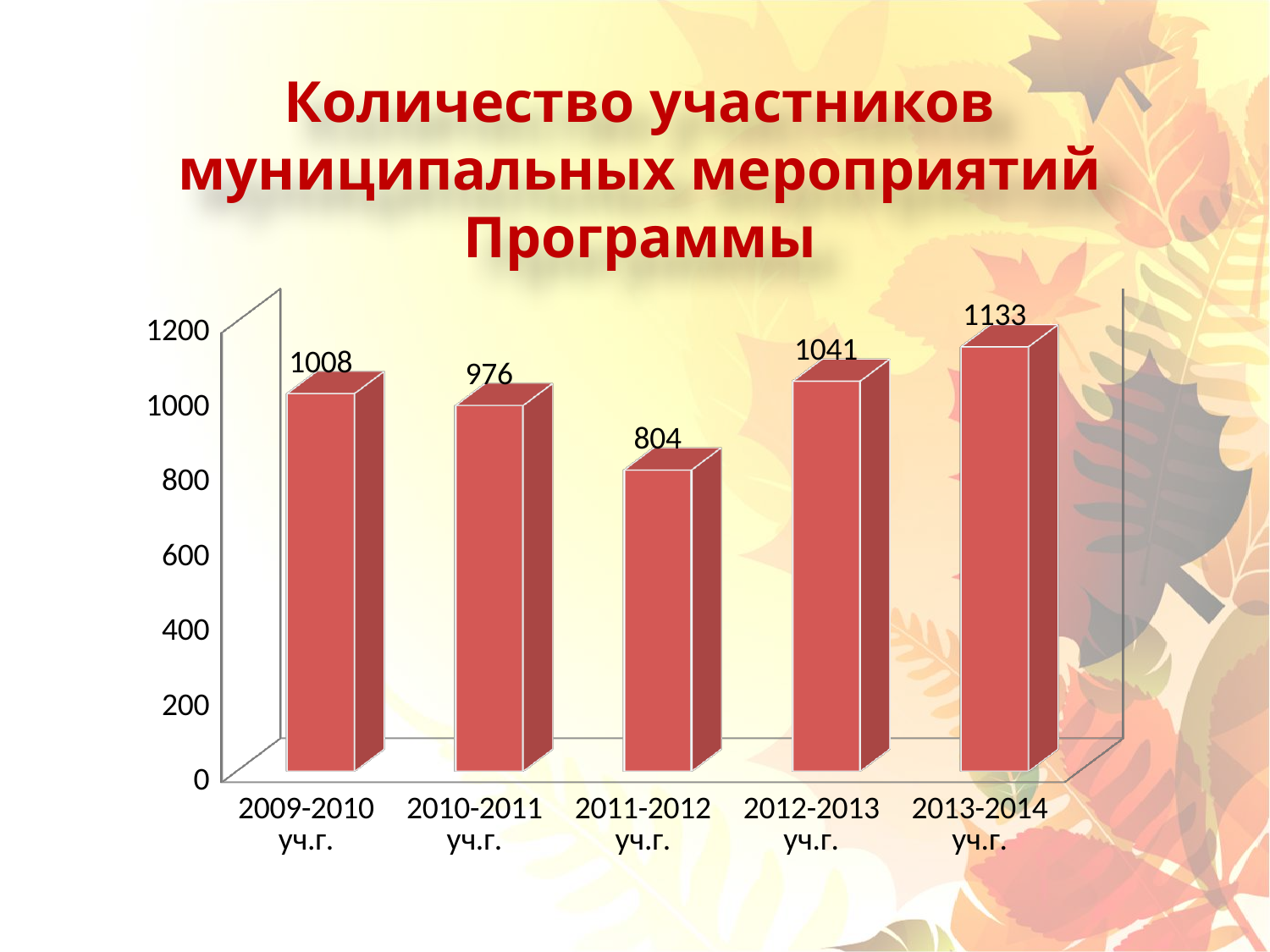
How many academic years are shown on the chart? 5 Is the value for 2011-2012 уч.г. greater or less than 1000? less What is the value for 2009-2010 уч.г.? 1008 What is the title of the chart on the slide? Количество участников муниципальных мероприятий Программы What is the value for 2013-2014 уч.г.? 1133 Which is larger, the value for 2012-2013 уч.г. or 2010-2011 уч.г.? 2012-2013 уч.г. Which academic year has the lowest number of participants? 2011-2012 уч.г. Which academic year has the highest number of participants? 2013-2014 уч.г. What kind of chart is shown on the slide? bar chart What is the difference between the values for 2009-2010 уч.г. and 2010-2011 уч.г.? 32 What is the value for 2011-2012 уч.г.? 804 What is the difference between the values for 2013-2014 уч.г. and 2011-2012 уч.г.? 329